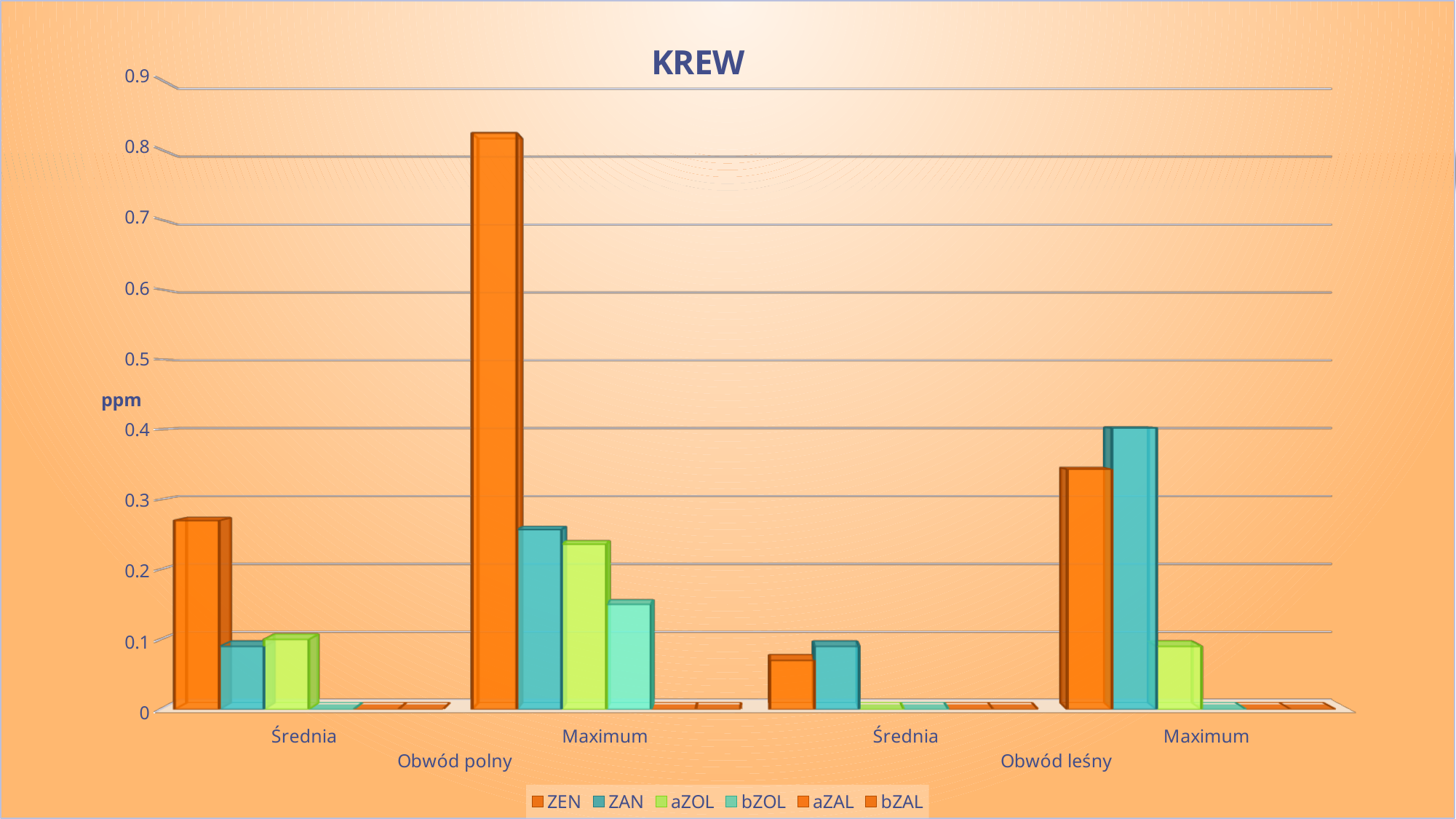
For Maximum in Obwód polny, which is larger: ZEN or ZAN? ZEN How many category groups (Średnia/Maximum) are shown along the x axis? 4 What kind of chart is shown on the slide? bar chart Is the ZEN value for Maximum in Obwód polny greater or less than 0.5? greater How many series does the legend list? 6 Is the bZOL value for Maximum in Obwód polny greater or less than 0.2? less For Maximum in Obwód leśny, which is larger: ZEN or ZAN? ZAN Is the ZEN value for Średnia in Obwód polny greater or less than 0.2? greater What is the title of the chart? KREW Which series has the tallest bar in the whole chart, and in which category? ZEN, Maximum (Obwód polny) What unit is shown on the vertical axis label? ppm